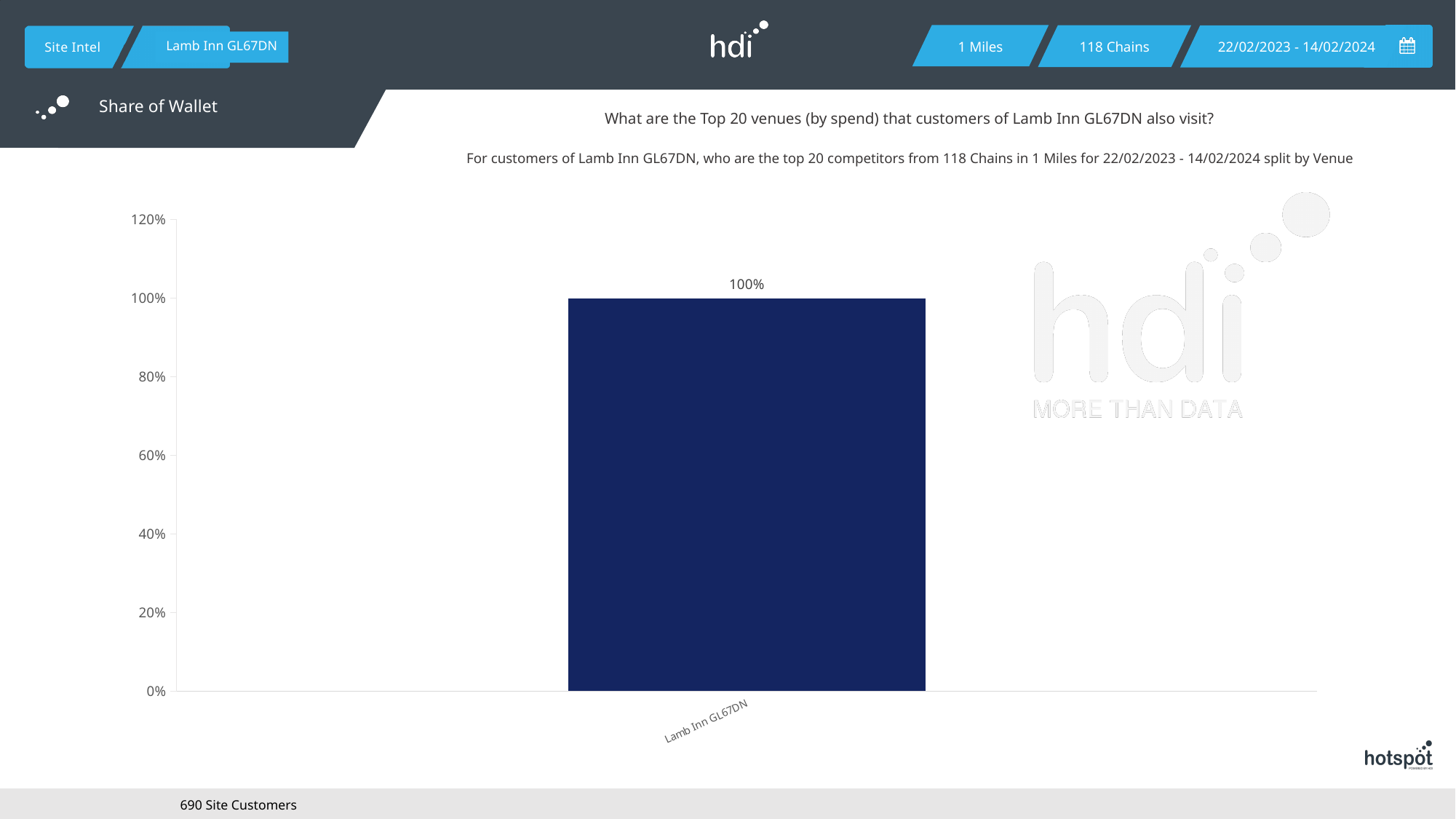
What is the highest value shown on the vertical axis of the chart? 120% How many bars are plotted in the chart? 1 Is the value for Lamb Inn GL67DN greater or less than 120%? less What kind of chart is shown on the slide? Bar chart Which category has the highest value in the chart? Lamb Inn GL67DN Is the value for Lamb Inn GL67DN greater or less than 80%? greater What is the label of the only category on the x axis of the chart? Lamb Inn GL67DN What is the value shown for Lamb Inn GL67DN in the chart? 100%